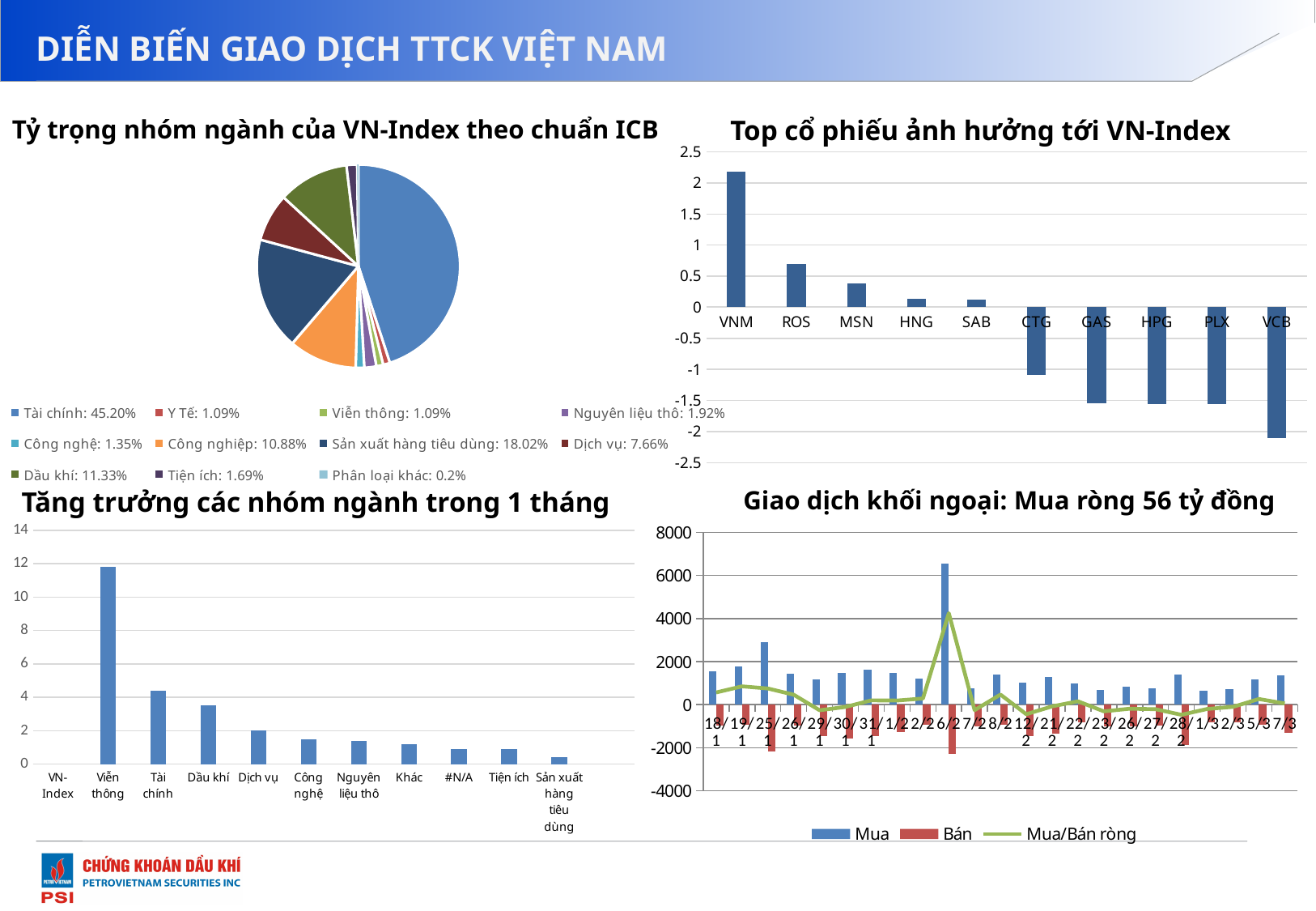
In the chart 'Tăng trưởng các nhóm ngành trong 1 tháng', which sector has the highest growth? Viễn thông In the chart 'Top cổ phiếu ảnh hưởng tới VN-Index', how many stocks are shown? 10 In the chart 'Top cổ phiếu ảnh hưởng tới VN-Index', which stock has the highest value? VNM In the chart 'Top cổ phiếu ảnh hưởng tới VN-Index', is the value for VNM greater or less than 2? greater In the pie chart 'Tỷ trọng nhóm ngành của VN-Index theo chuẩn ICB', which is larger, Công nghiệp or Dầu khí? Dầu khí In the pie chart 'Tỷ trọng nhóm ngành của VN-Index theo chuẩn ICB', what share does Sản xuất hàng tiêu dùng have? 18.02% In the pie chart 'Tỷ trọng nhóm ngành của VN-Index theo chuẩn ICB', how many sectors are listed in the legend? 11 In the pie chart 'Tỷ trọng nhóm ngành của VN-Index theo chuẩn ICB', what share does Tài chính have? 45.20% In the chart 'Top cổ phiếu ảnh hưởng tới VN-Index', which stock has the lowest value? VCB In the chart 'Tăng trưởng các nhóm ngành trong 1 tháng', is the value for Viễn thông greater or less than 10? greater In the chart 'Giao dịch khối ngoại: Mua ròng 56 tỷ đồng', how many series does the legend list? 3 In the pie chart 'Tỷ trọng nhóm ngành của VN-Index theo chuẩn ICB', which sector has the largest share? Tài chính